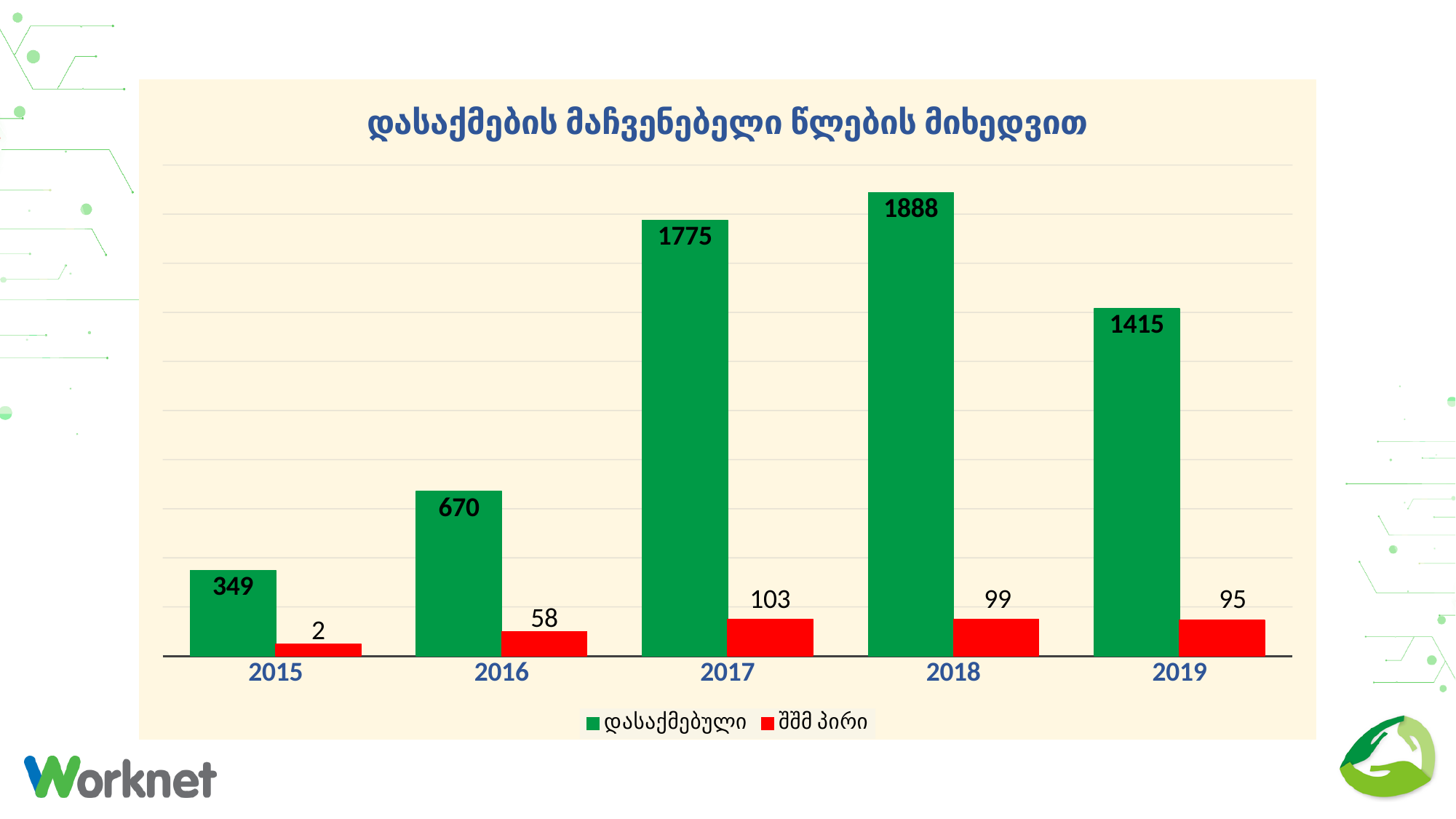
Does the green series (დასაქმებული) rise or fall from 2015 to 2018? Rise What is the value of the red series (შშმ პირი) for 2015? 2 What kind of chart is shown on the slide? Bar chart In which year is the green series (დასაქმებული) highest? 2018 Which is larger: the green series value for 2016 or for 2019? 2019 What is the value of the green series (დასაქმებული) for 2017? 1775 How many years are shown on the x axis? 5 How many series does the legend list? 2 What is the difference between the green series values for 2018 and 2019? 473 In which year is the red series (შშმ პირი) lowest? 2015 What is the difference between the red series values for 2017 and 2018? 4 What is the value of the red series (შშმ პირი) for 2016? 58